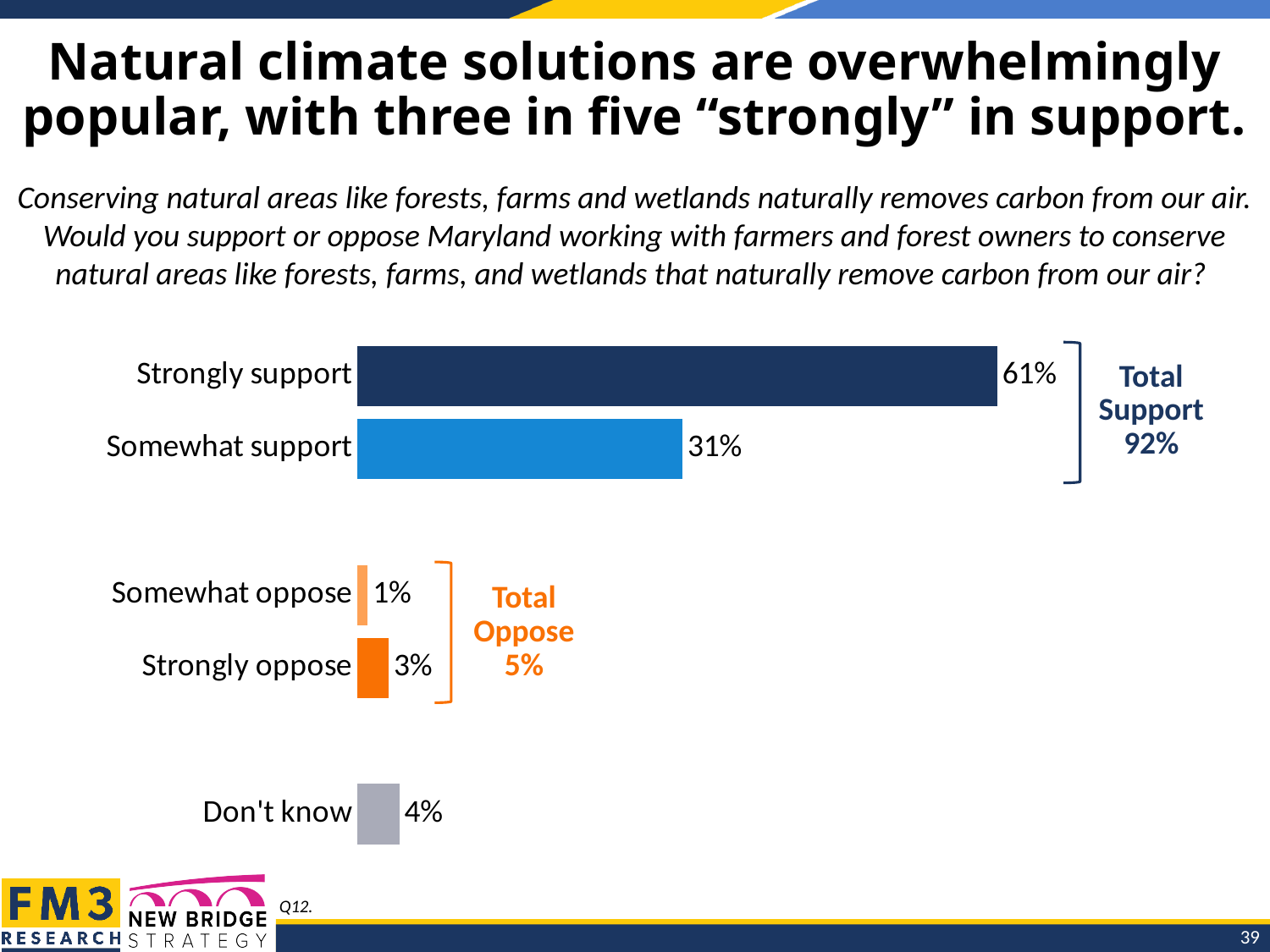
What is the Total Oppose percentage shown on the slide? 5% What is the difference between "Strongly support" and "Somewhat support"? 30 percentage points What percentage of respondents said they strongly support the proposal? 61% What is the value for "Somewhat oppose"? 1% What kind of chart is shown on the slide? Bar chart What is the Total Support percentage shown on the slide? 92% Which is larger, "Strongly oppose" or "Don't know"? Don't know What percentage of respondents said "Don't know"? 4% How many response categories are plotted in the chart? 5 Which response category has the highest value? Strongly support What is the value shown for "Somewhat support"? 31% Which response category has the lowest value? Somewhat oppose